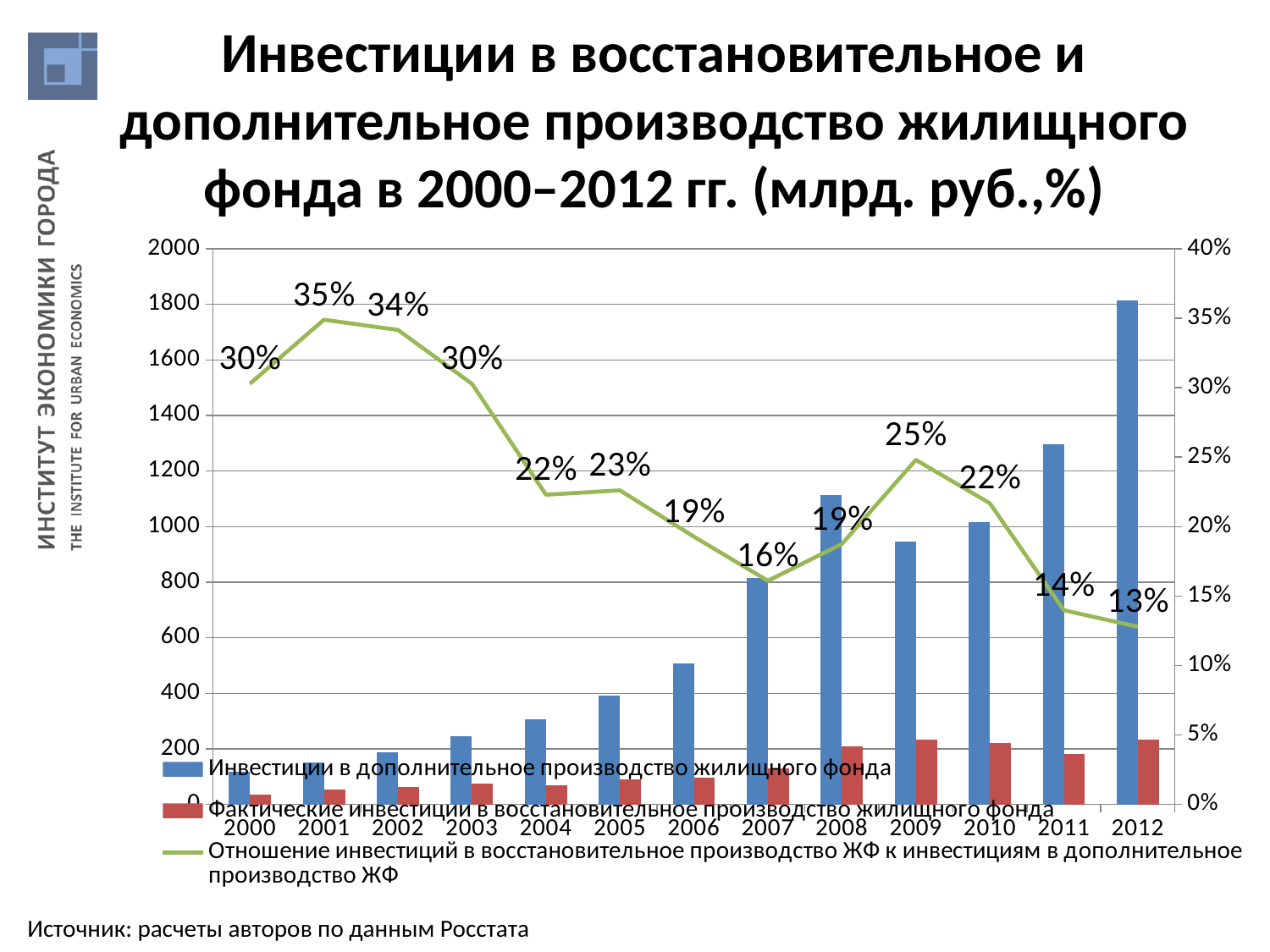
How many years are shown on the x axis of the chart? 13 What is the ratio value shown on the green line for 2012? 13% What is the ratio of investments in restorative production to investments in additional production (green line) for 2001? 35% In which year is the ratio shown on the green line the highest? 2001 Is the value of the blue bar (investments in additional housing production) for 2000 greater or less than 200? less How many series does the legend list? 3 Is the value of the blue bar (investments in additional housing production) for 2012 greater or less than 1600? greater Which year has a higher ratio on the green line, 2009 or 2010? 2009 By how many percentage points does the ratio in 2001 exceed the ratio in 2012? 22 percentage points Do the blue bars (investments in additional housing production) generally rise or fall from 2000 to 2012? rise What kind of chart is shown on the slide? Combination bar and line chart In which year is the ratio shown on the green line the lowest? 2012